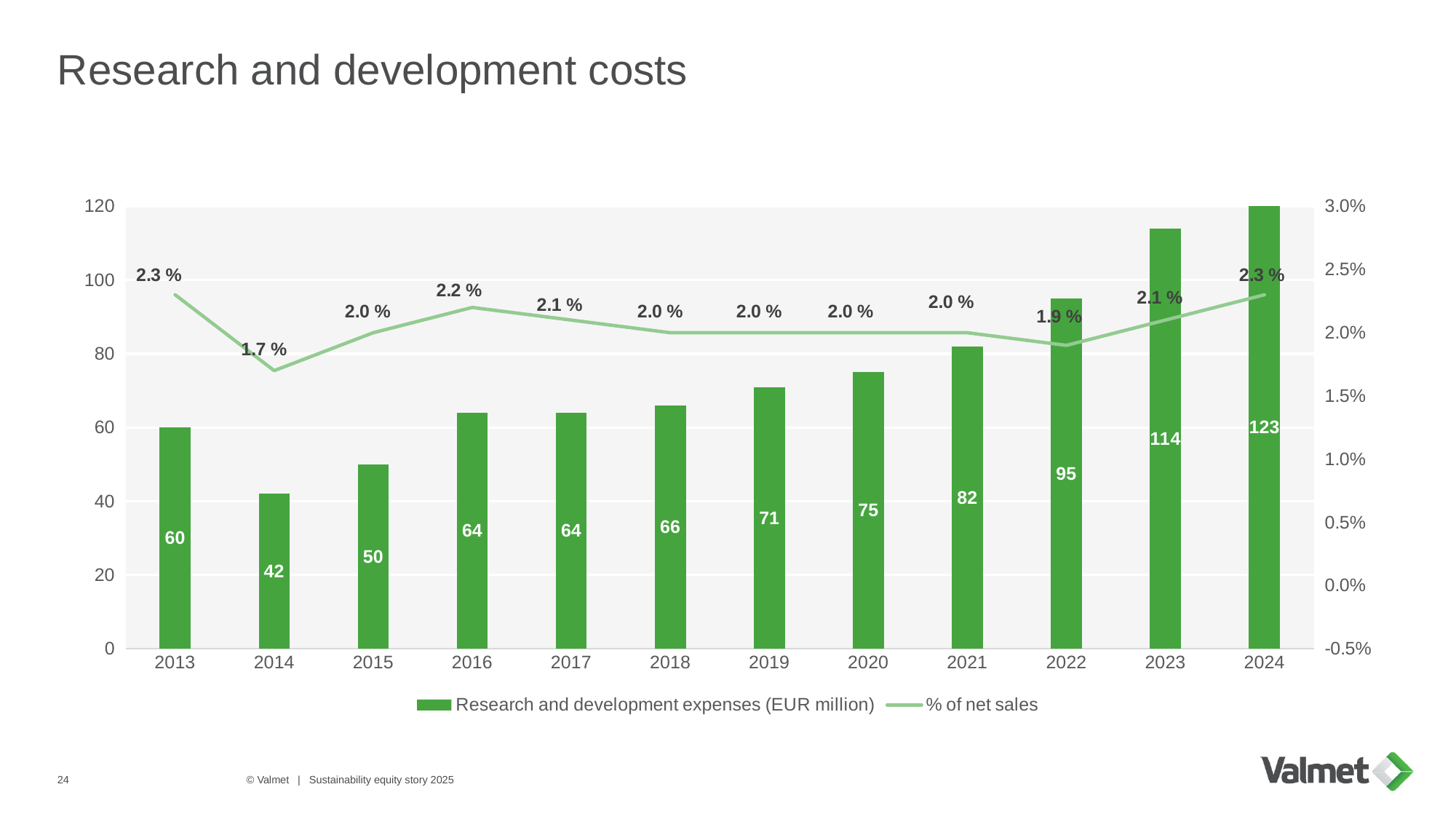
Which year had higher research and development expenses, 2015 or 2018? 2018 What was the % of net sales value for 2014? 1.7 % Which year has the highest research and development expenses? 2024 What were the research and development expenses (EUR million) in 2019? 71 Do the research and development expenses generally rise or fall from 2014 to 2024? Rise How many series does the legend list? 2 How many years are shown on the x axis? 12 What were the research and development expenses (EUR million) in 2024? 123 Which year has the lowest % of net sales? 2014 Which year has the lowest research and development expenses? 2014 What kind of chart is used for the research and development expenses series? Bar chart What is the difference in research and development expenses (EUR million) between 2024 and 2023? 9